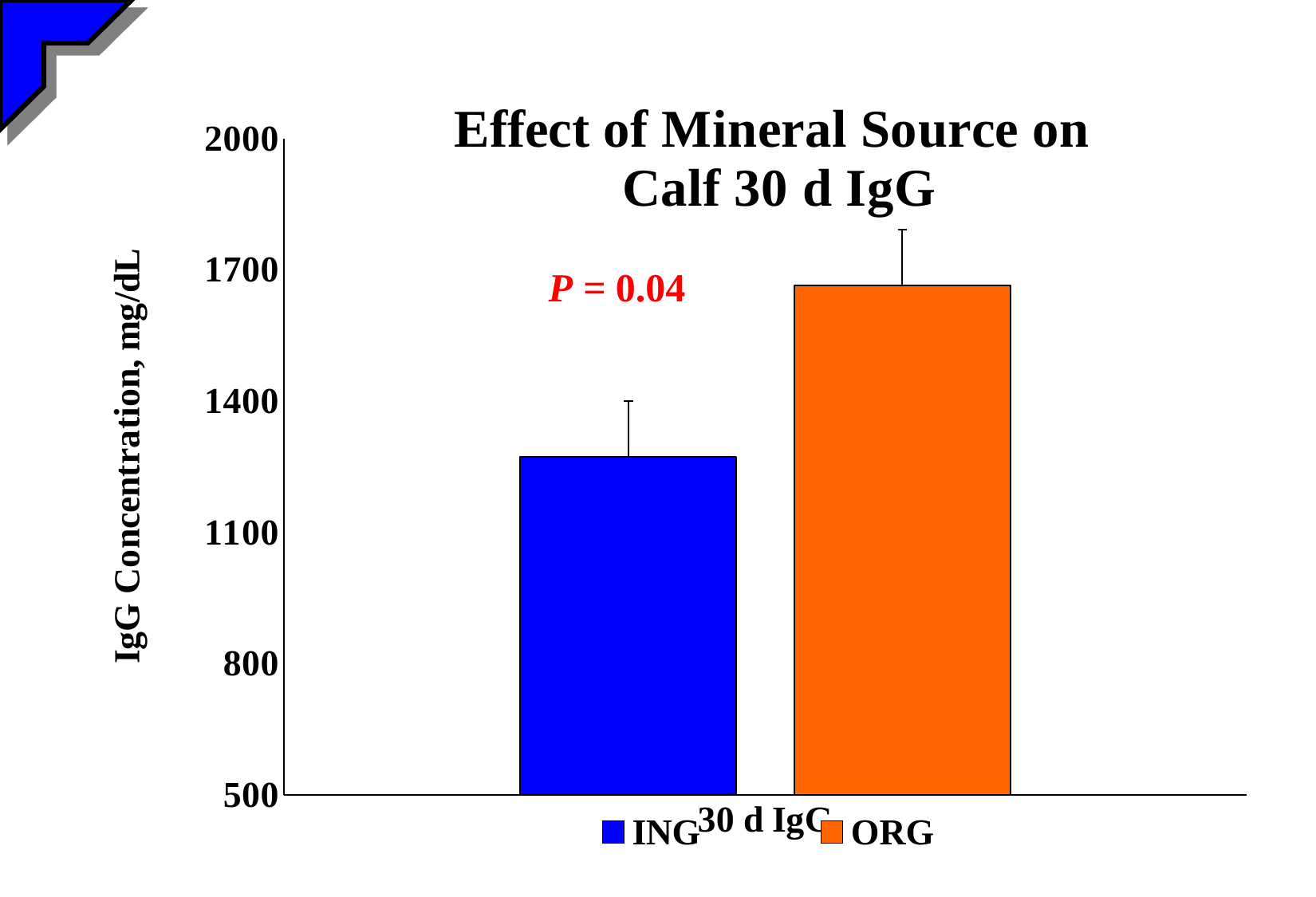
How many series does the legend list? 2 What kind of chart is shown on the slide? bar chart Is the value for ORG greater or less than 1700? less Is the value for ING larger or smaller than the value for ORG? smaller Is the value for ING greater or less than 1100? greater Which series has the lower IgG concentration? ING Is the value for ORG greater or less than 1400? greater How many bars are plotted in the chart? 2 What P value is printed on the chart? P = 0.04 What is the title of the chart? Effect of Mineral Source on Calf 30 d IgG Which series has the higher IgG concentration, ING or ORG? ORG